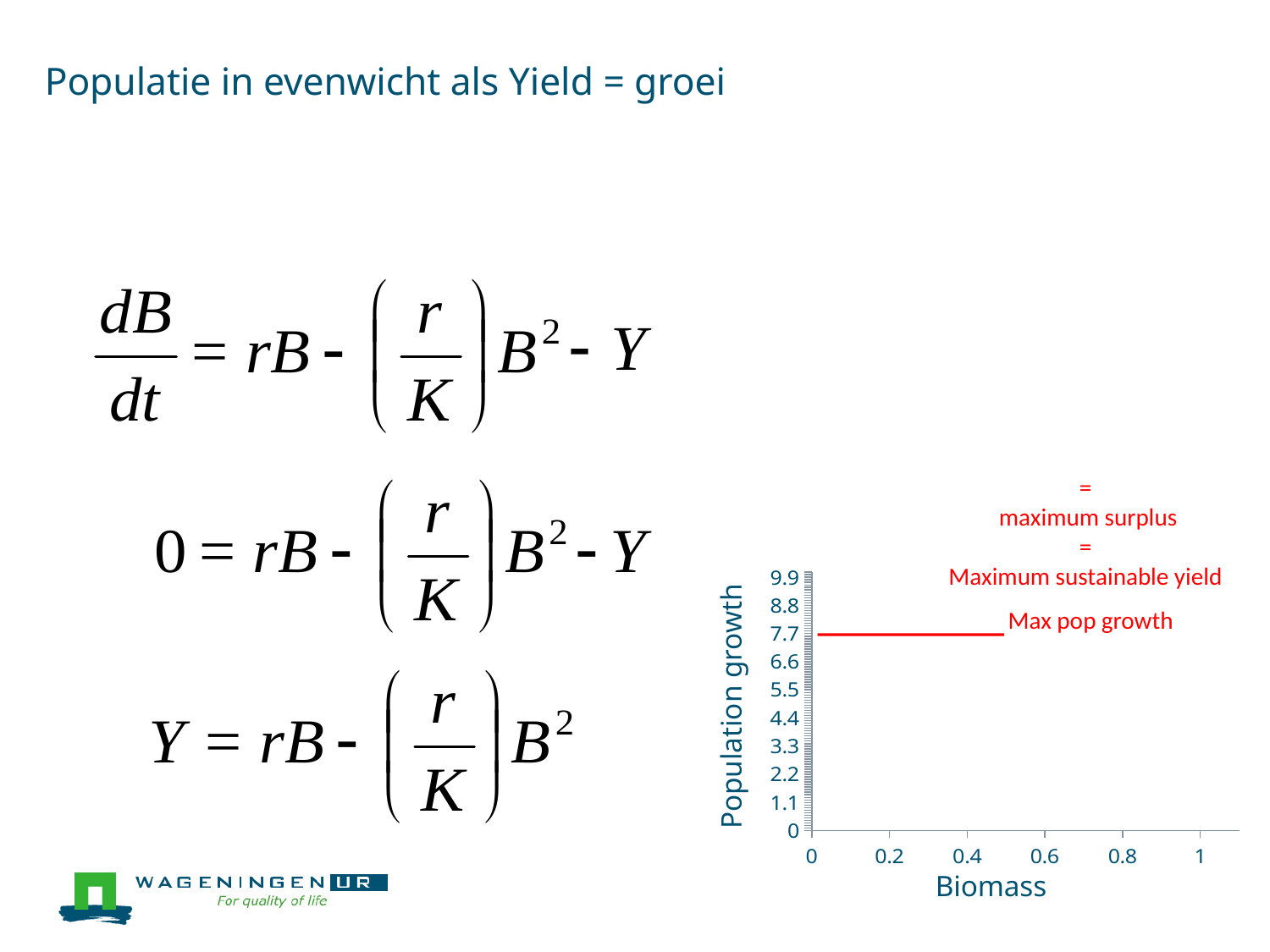
What label is written next to the red horizontal line on the chart? Max pop growth How many labelled tick values are shown on the x axis of the chart? 6 What is the highest tick value shown on the y axis of the chart? 9.9 What is the title of the y axis of the chart? Population growth At which y-axis tick value does the red horizontal line labelled 'Max pop growth' sit? 7.7 Is the level of the red 'Max pop growth' line greater or less than 8.8? less According to the red annotation, the maximum population growth equals the maximum surplus and what else? Maximum sustainable yield How many labelled tick values are shown on the y axis of the chart? 10 What is the title of the x axis of the chart? Biomass What is the spacing between consecutive labelled ticks on the x axis of the chart? 0.2 What is the highest tick value shown on the x axis of the chart? 1 Is the level of the red 'Max pop growth' line greater or less than 5.5? greater